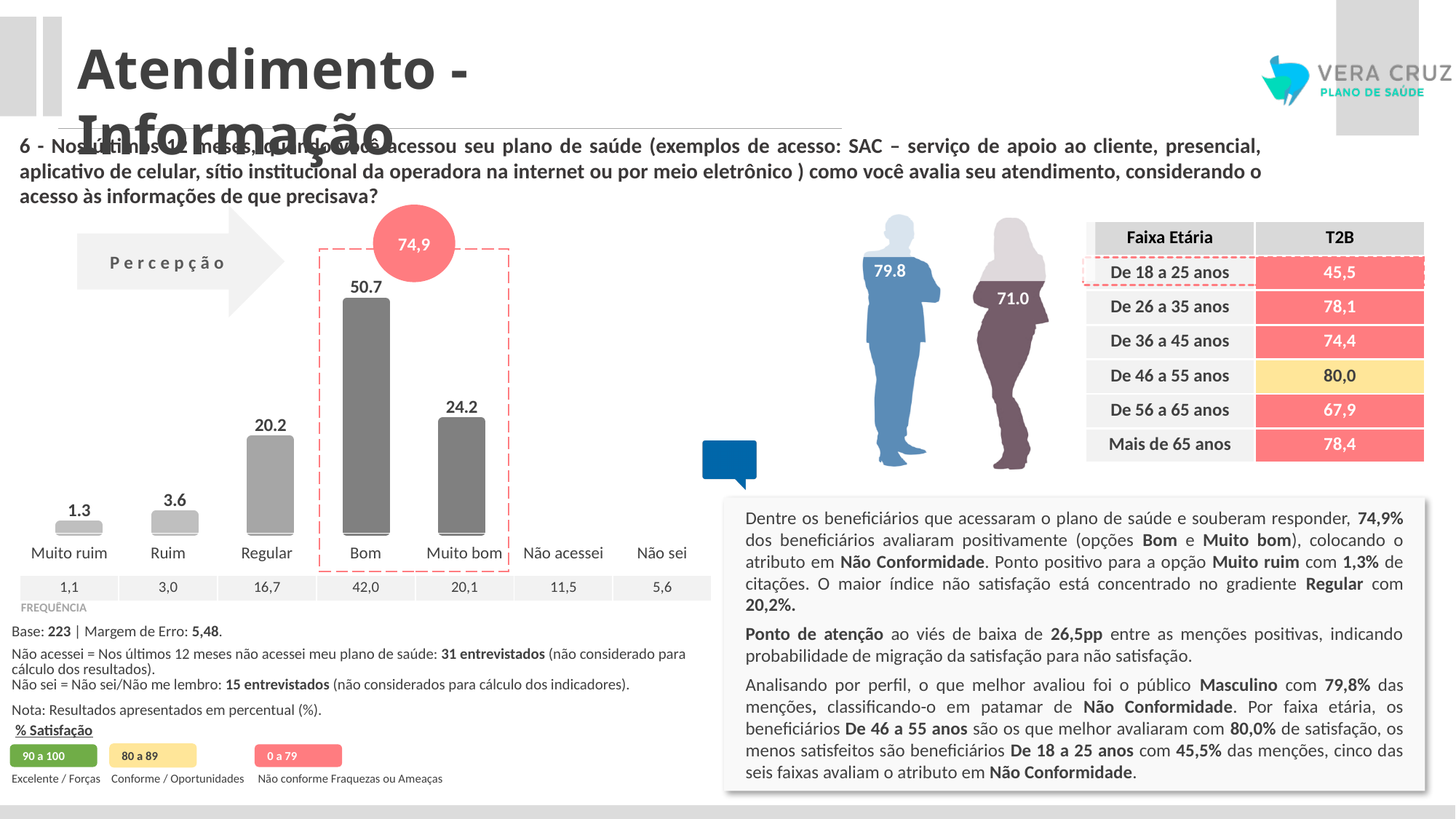
What value is shown in the red circle above the dashed box around 'Bom' and 'Muito bom'? 74,9 What type of chart is used to show the evaluation categories from 'Muito ruim' to 'Muito bom'? bar chart Which is larger in the bar chart, 'Regular' or 'Muito bom'? Muito bom Which category has the highest value in the bar chart? Bom What is the value shown for 'Muito ruim' in the bar chart? 1.3 What is the value shown for 'Regular' in the bar chart? 20.2 What is the sum of the values for 'Bom' and 'Muito bom' in the bar chart? 74.9 What is the value shown for the 'Bom' category in the bar chart? 50.7 What is the value shown for 'Muito bom' in the bar chart? 24.2 How many categories have a bar plotted in the bar chart? 5 Which category has the lowest value among the plotted bars? Muito ruim What is the difference between the values for 'Bom' and 'Muito bom' in the bar chart? 26.5